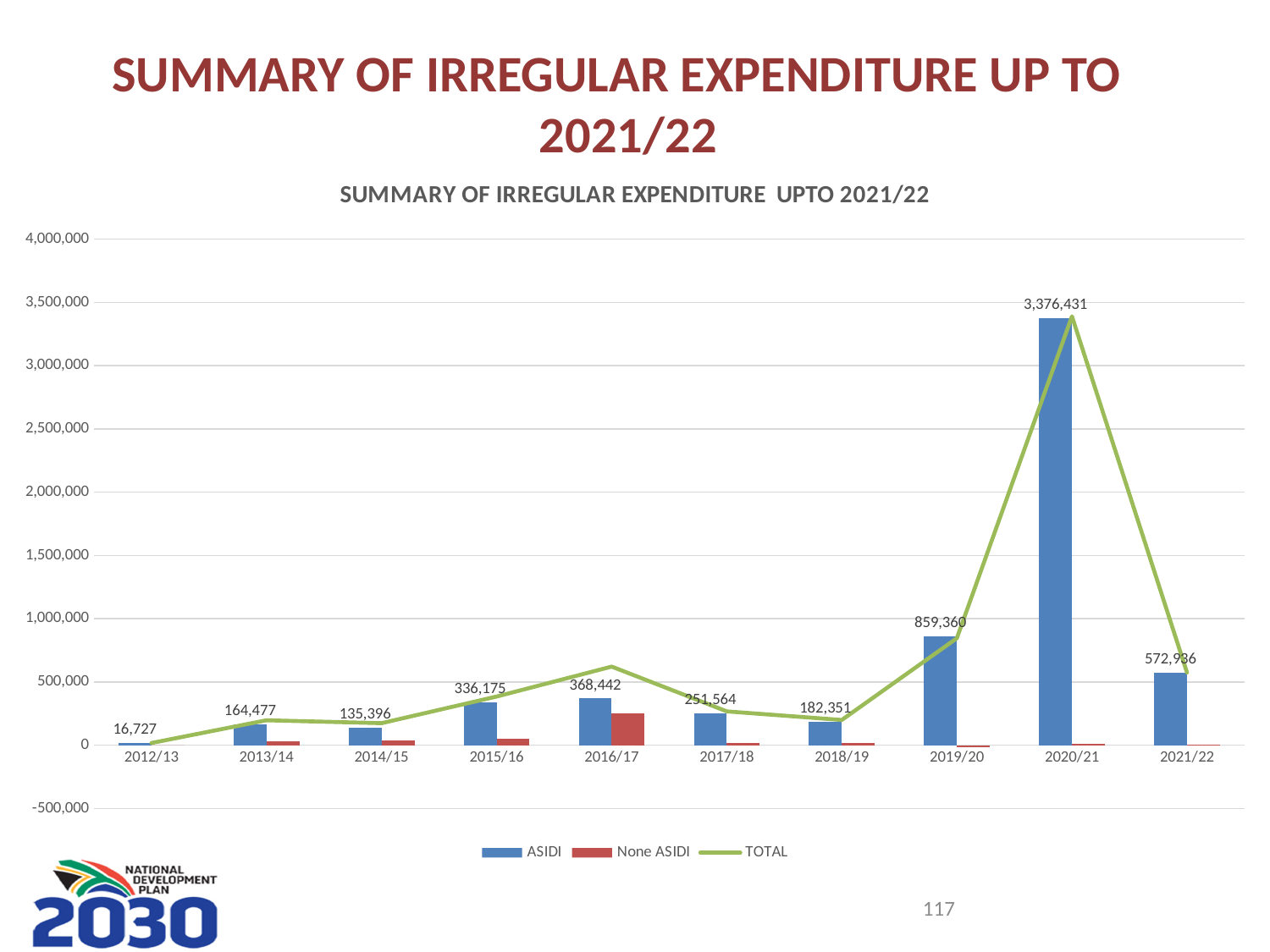
What is the difference between the ASIDI values for 2013/14 and 2014/15? 29,081 How many financial years are shown on the x axis? 10 Which year has the larger ASIDI value, 2015/16 or 2016/17? 2016/17 What is the difference between the ASIDI values for 2019/20 and 2018/19? 677,009 Which year has the lowest ASIDI value? 2012/13 What is the ASIDI value for 2019/20? 859,360 How many series does the legend list? 3 What is the ASIDI value for 2012/13? 16,727 Which year has the highest ASIDI value? 2020/21 Is the None ASIDI value for 2016/17 greater or less than 500,000? less What kind of chart is shown on the slide? A bar chart combined with a line chart What is the ASIDI value for 2020/21? 3,376,431